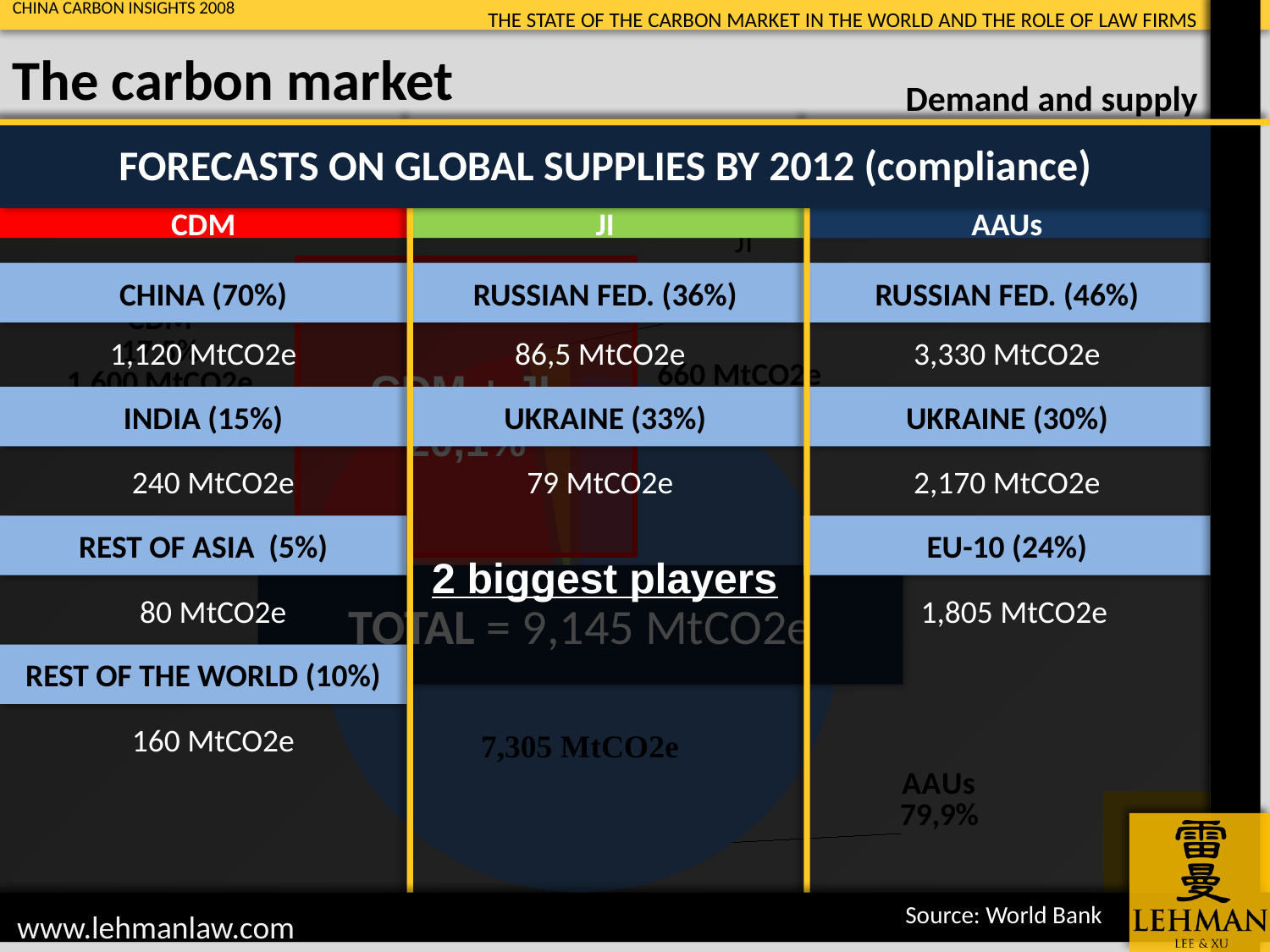
How many supply categories (CDM, JI, AAUs) does the pie chart break down? 3 What value in MtCO2e is labelled for the AAUs slice of the pie chart? 7,305 MtCO2e Which slice of the pie chart is the largest? AAUs What is the heading above the chart area on the slide? FORECASTS ON GLOBAL SUPPLIES BY 2012 (compliance) Is the AAUs share of the pie chart greater or less than 50%? greater What source is cited for the chart data on the slide? World Bank What share of the pie chart is labelled for AAUs? 79,9% What kind of chart is partially visible behind the tables on the slide? pie chart